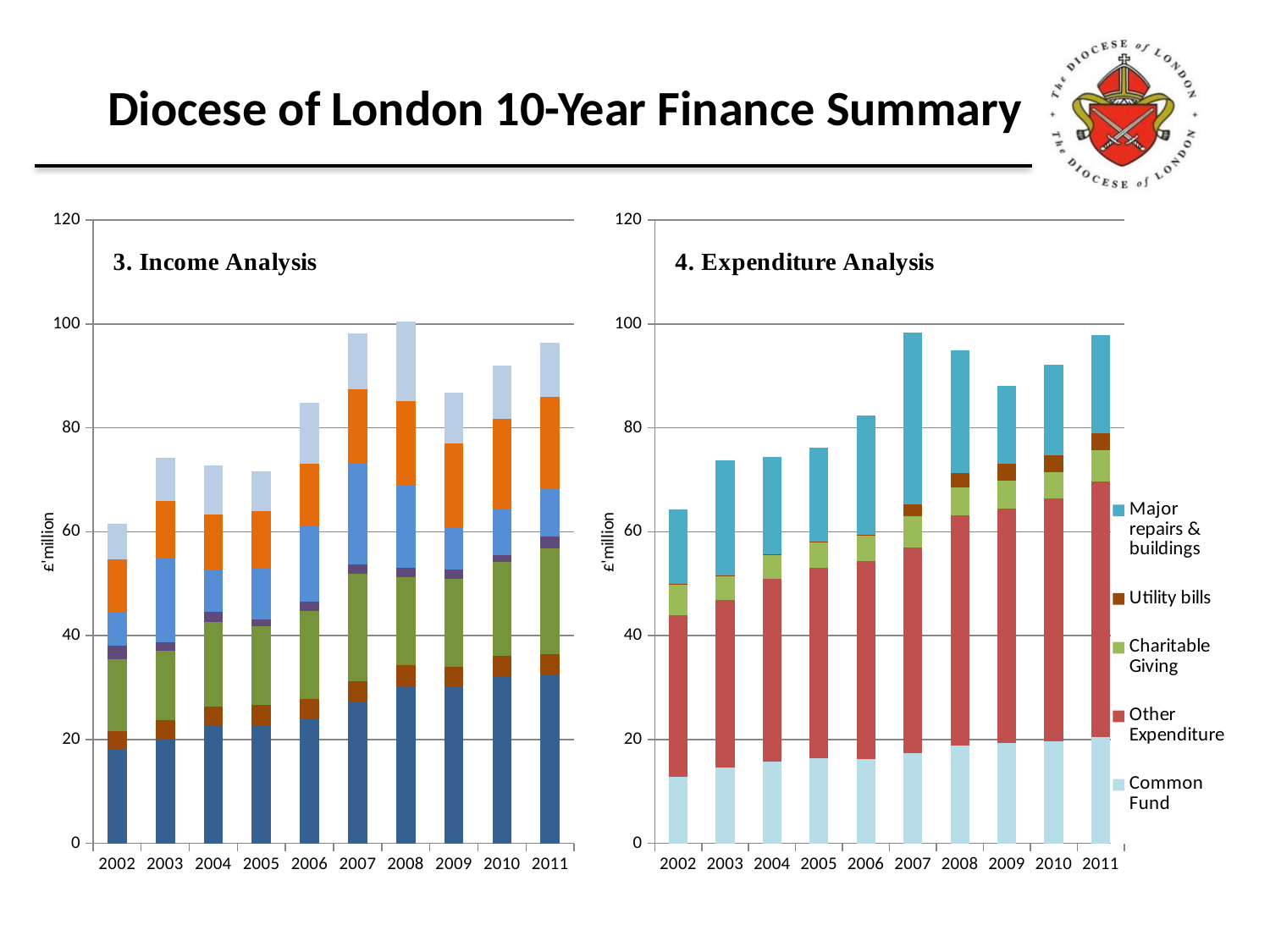
In the '3. Income Analysis' chart, which year has the highest total income? 2008 What is the y-axis label on the '4. Expenditure Analysis' chart? £'million What kind of chart is the '3. Income Analysis' chart? stacked bar chart In the '4. Expenditure Analysis' chart, does the Common Fund value generally rise or fall from 2002 to 2011? rise In the '4. Expenditure Analysis' chart, which year has the larger total expenditure, 2009 or 2010? 2010 In the '3. Income Analysis' chart, which year has the lowest total income? 2002 In the '4. Expenditure Analysis' chart, which year has the lowest total expenditure? 2002 In the '4. Expenditure Analysis' chart, is the Common Fund value for 2002 greater or less than 20? less How many series does the legend of the '4. Expenditure Analysis' chart list? 5 In the '4. Expenditure Analysis' chart, is the total expenditure for 2007 greater or less than 80? greater How many years are shown on the x axis of the '4. Expenditure Analysis' chart? 10